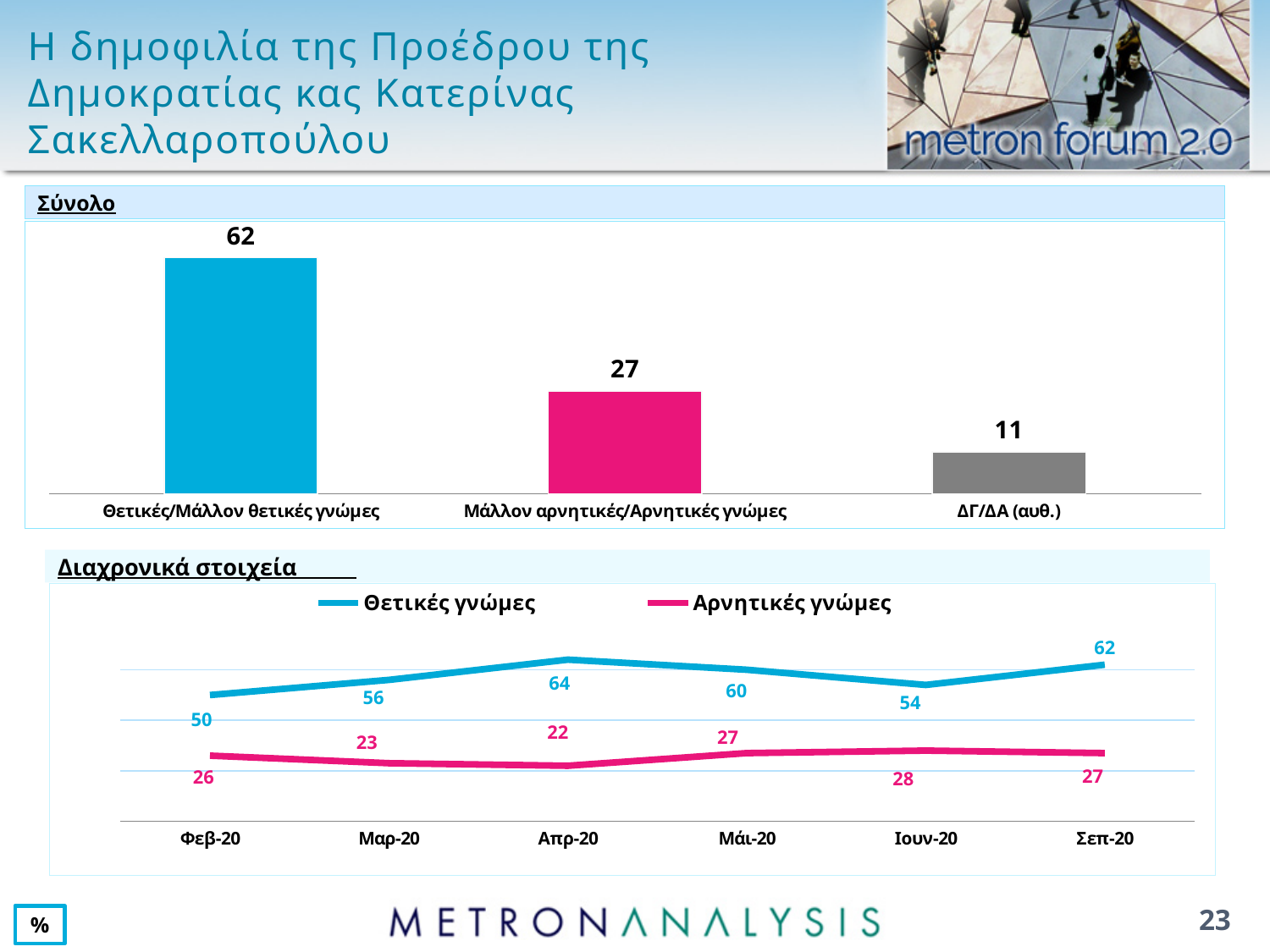
In the 'Σύνολο' chart, what is the difference between 'Θετικές/Μάλλον θετικές γνώμες' and 'Μάλλον αρνητικές/Αρνητικές γνώμες'? 35 In the 'Διαχρονικά στοιχεία' chart, what is the value of 'Θετικές γνώμες' for Απρ-20? 64 In the 'Διαχρονικά στοιχεία' chart, in which month does 'Θετικές γνώμες' reach its highest value? Απρ-20 In the 'Διαχρονικά στοιχεία' chart, what is the value of 'Αρνητικές γνώμες' for Ιουν-20? 28 In the 'Διαχρονικά στοιχεία' chart, in which month is 'Αρνητικές γνώμες' lowest? Απρ-20 In the 'Διαχρονικά στοιχεία' chart, what is the difference between 'Θετικές γνώμες' and 'Αρνητικές γνώμες' in Σεπ-20? 35 In the 'Διαχρονικά στοιχεία' chart, how many series does the legend list? 2 What kind of chart is the 'Σύνολο' chart? bar chart In the 'Διαχρονικά στοιχεία' chart, how many time points are shown on the x axis? 6 In the 'Σύνολο' chart, what is the value for 'Θετικές/Μάλλον θετικές γνώμες'? 62 In the 'Σύνολο' chart, how many categories are shown? 3 In the 'Σύνολο' chart, which category has the lowest value? ΔΓ/ΔΑ (αυθ.)